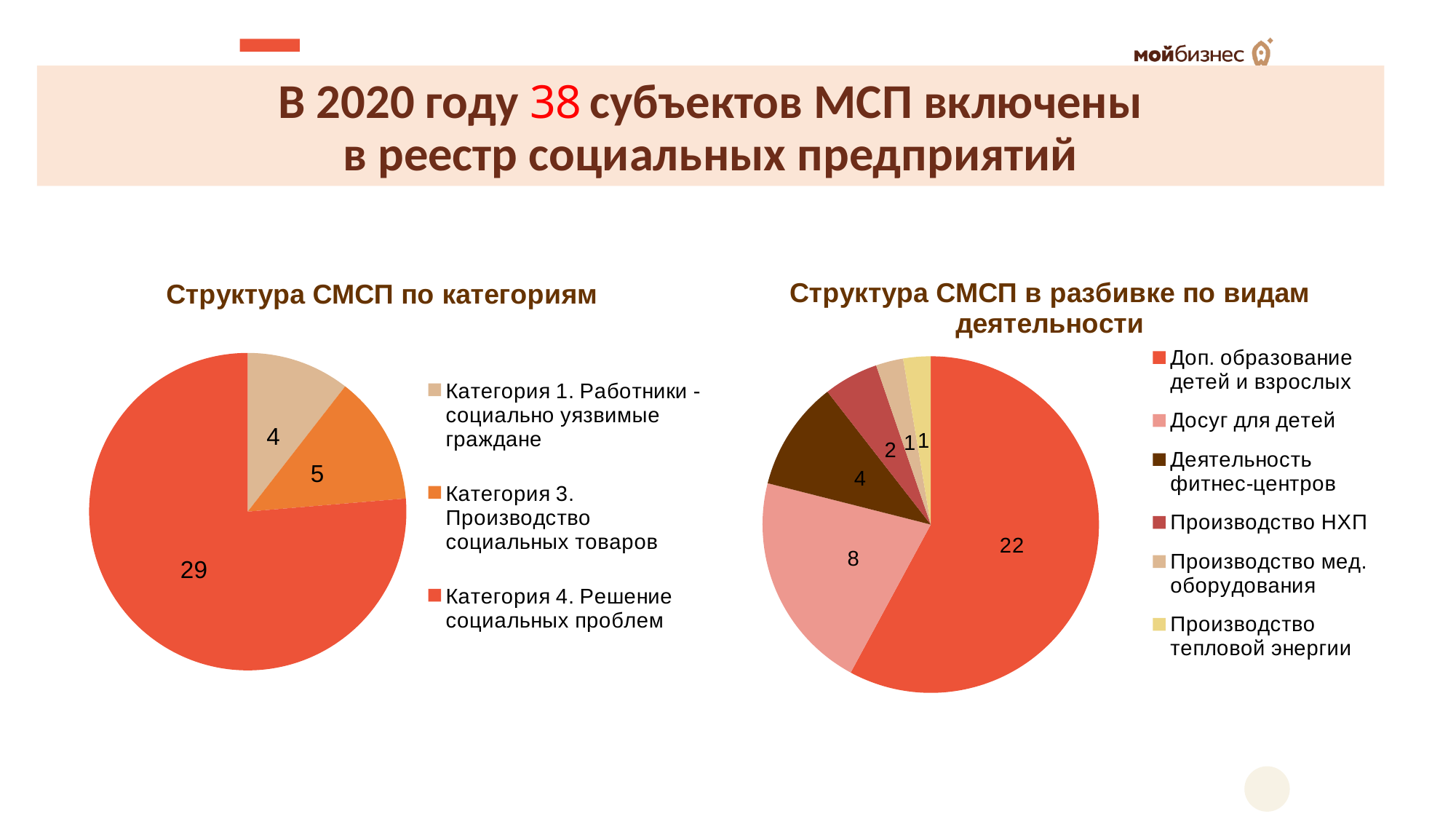
In the chart "Структура СМСП по категориям", what is the value for "Категория 4. Решение социальных проблем"? 29 In the chart "Структура СМСП в разбивке по видам деятельности", which activity type has the largest slice? Доп. образование детей и взрослых How many categories does the legend of the chart "Структура СМСП по категориям" list? 3 How many activity types does the legend of the chart "Структура СМСП в разбивке по видам деятельности" list? 6 In the chart "Структура СМСП в разбивке по видам деятельности", what is the value for "Доп. образование детей и взрослых"? 22 In the chart "Структура СМСП в разбивке по видам деятельности", which is larger: "Деятельность фитнес-центров" or "Производство НХП"? Деятельность фитнес-центров What kind of chart is the chart titled "Структура СМСП по категориям"? Pie chart In the chart "Структура СМСП по категориям", which category has the smallest slice? Категория 1. Работники - социально уязвимые граждане In the chart "Структура СМСП в разбивке по видам деятельности", what is the difference between the values for "Досуг для детей" and "Деятельность фитнес-центров"? 4 In the chart "Структура СМСП по категориям", what is the difference between the values for Категория 4 and Категория 3? 24 In the chart "Структура СМСП по категориям", what is the value for "Категория 3. Производство социальных товаров"? 5 In the chart "Структура СМСП в разбивке по видам деятельности", what is the value for "Досуг для детей"? 8